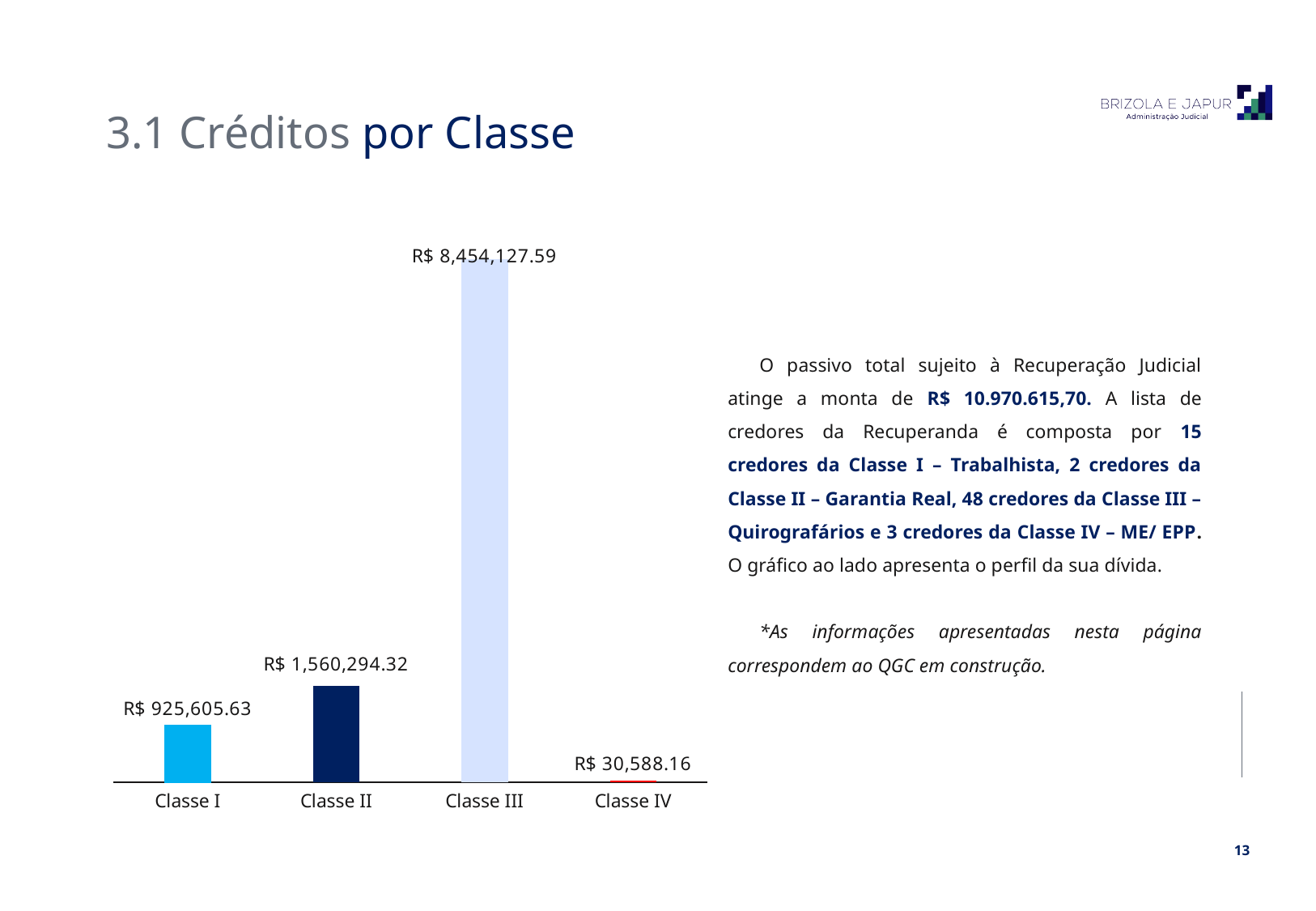
What colour is the bar for Classe IV? Red How many classes are shown in the chart? 4 Which class has the lowest value? Classe IV What is the value for Classe I? R$ 925,605.63 What is the difference between the values for Classe III and Classe II? R$ 6,893,833.27 What is the value for Classe III? R$ 8,454,127.59 What is the value for Classe IV? R$ 30,588.16 Which class has the highest value? Classe III Which is larger, the value for Classe I or the value for Classe II? Classe II What kind of chart is shown on the slide? Bar chart What is the difference between the values for Classe II and Classe I? R$ 634,688.69 What is the value for Classe II? R$ 1,560,294.32